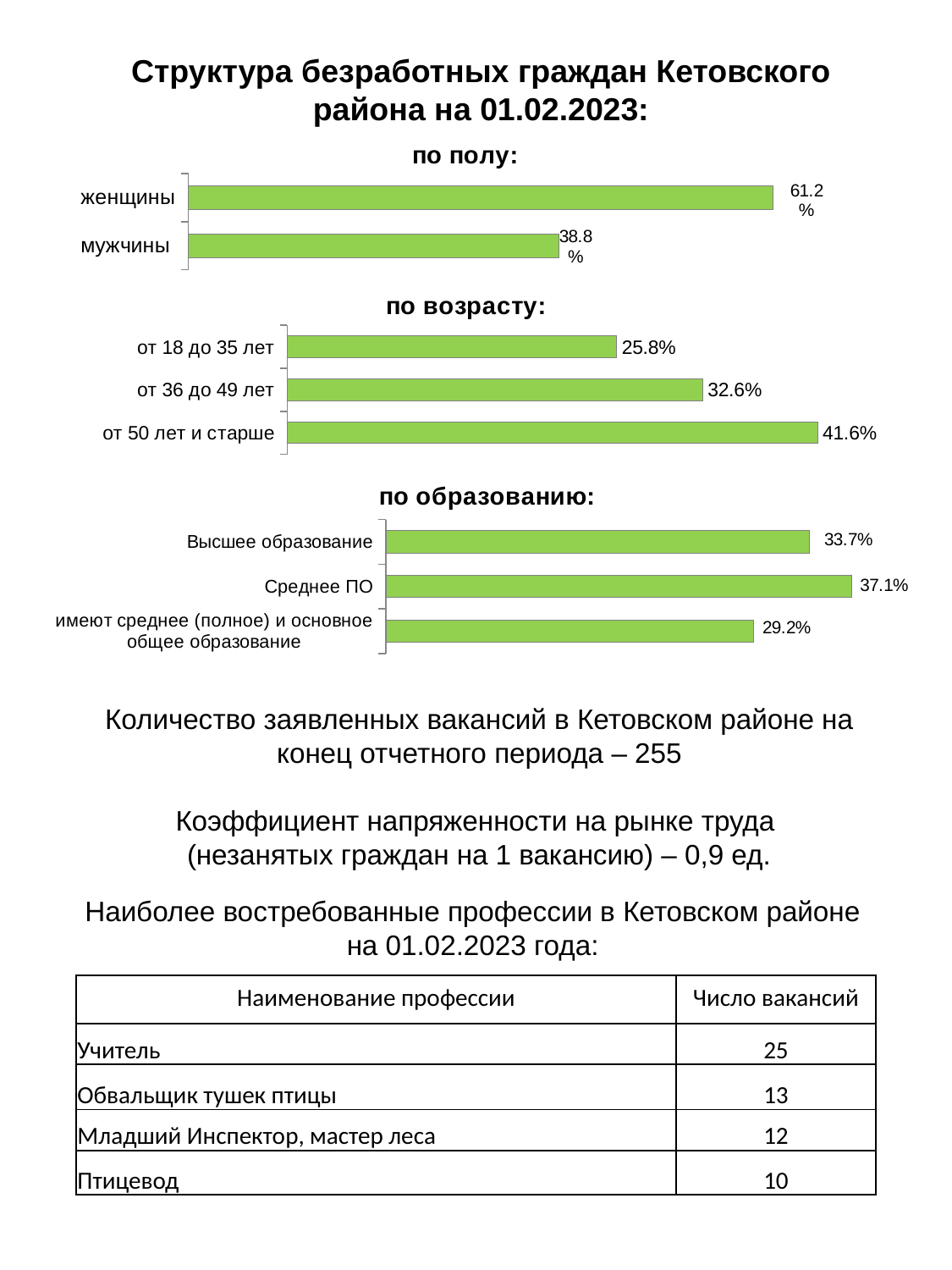
In the chart titled "по возрасту:", which category has the highest value? от 50 лет и старше In the chart titled "по возрасту:", what is the value for от 36 до 49 лет? 32.6% In the chart titled "по полу:", what is the difference between the values for женщины and мужчины? 22.4% In the chart titled "по образованию:", which is larger: Высшее образование or имеют среднее (полное) и основное общее образование? Высшее образование In the chart titled "по образованию:", what is the value for Среднее ПО? 37.1% In the chart titled "по полу:", what is the value for мужчины? 38.8% In the chart titled "по возрасту:", which category has the lowest value? от 18 до 35 лет In the chart titled "по возрасту:", how many categories are shown? 3 In the chart titled "по образованию:", what is the difference between Среднее ПО and Высшее образование? 3.4% In the chart titled "по возрасту:", do the values rise or fall going from от 18 до 35 лет to от 50 лет и старше? rise In the chart titled "по полу:", what is the value for женщины? 61.2% What type of chart is the chart titled "по полу:"? bar chart